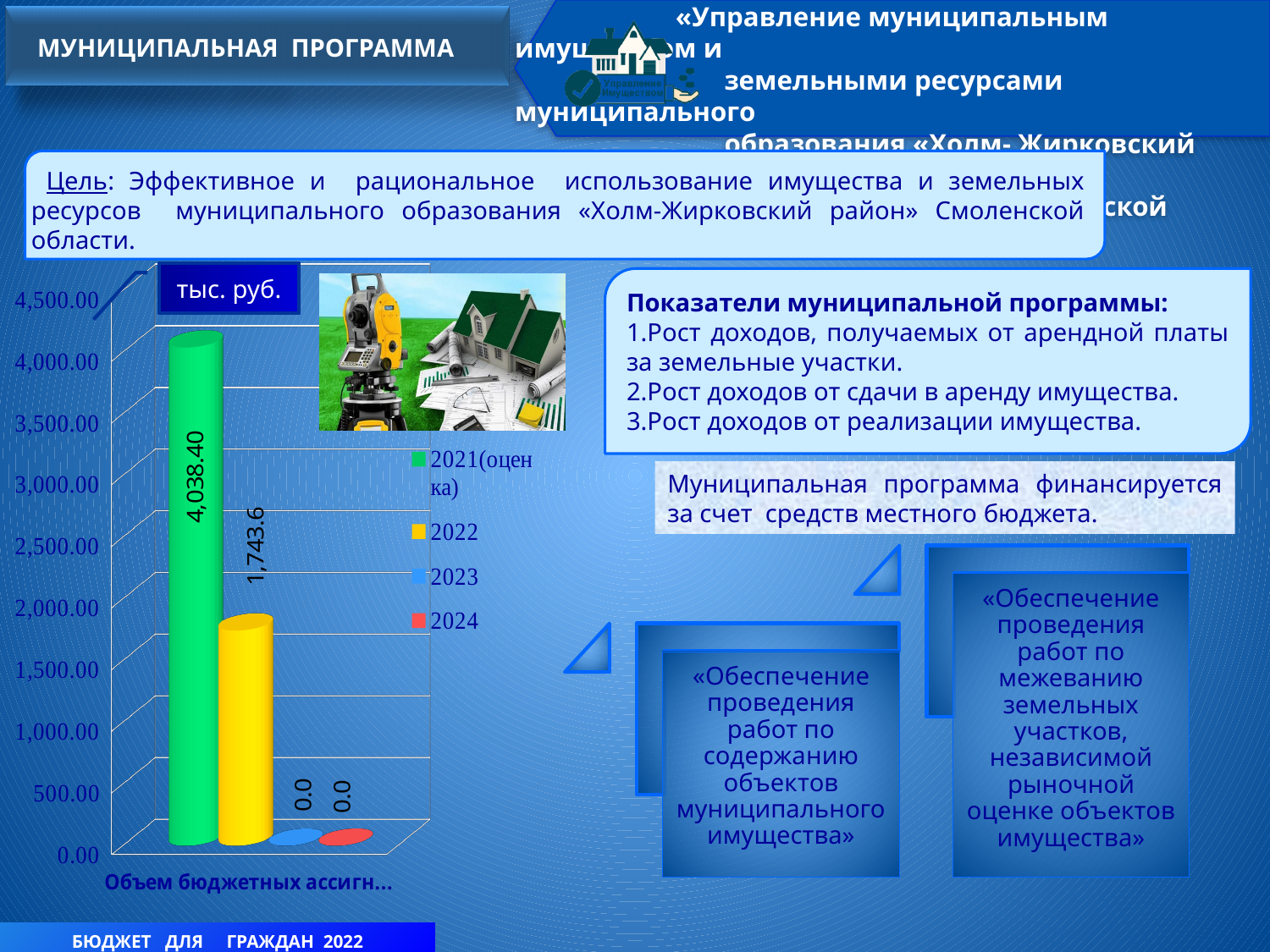
What is the value for 2023 on the chart? 0.0 What is the value for 2024 on the chart? 0.0 How many series does the chart legend list? 4 Which series has the highest value on the chart? 2021(оценка) What unit is shown in the label above the chart? тыс. руб. Is the value for 2021(оценка) greater or less than 4,000.00? greater What kind of chart is shown on the slide? bar chart What is the value for 2021(оценка) on the chart? 4,038.40 Is the value for 2022 greater or less than 2,000.00? less What is the value for 2022 on the chart? 1,743.6 Which is larger, the value for 2021(оценка) or the value for 2022? 2021(оценка) What colour is the bar for 2022 on the chart? yellow